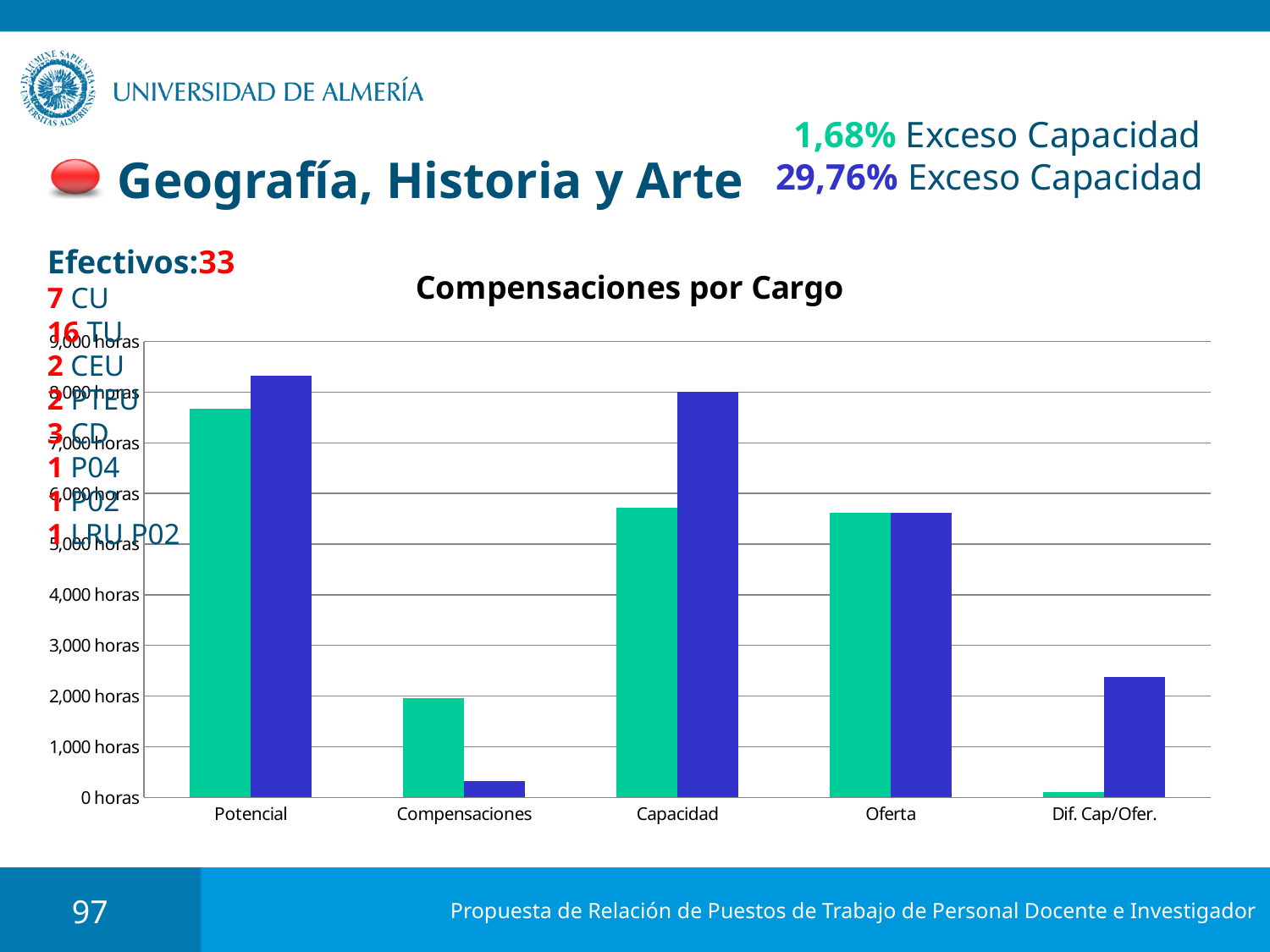
Is the green bar for Compensaciones greater or less than 3,000 horas? less Is the blue bar for Dif. Cap/Ofer. greater or less than 2,000 horas? greater Which category has the tallest green bar? Potencial Which category has the shortest blue bar? Compensaciones Which is larger, the green bar for Potencial or the green bar for Compensaciones? Potencial Is the blue bar for Capacidad greater or less than 7,000 horas? greater How many categories are shown on the x axis of the chart? 5 For Capacidad, which bar is taller, the green one or the blue one? the blue one Which category has the shortest green bar? Dif. Cap/Ofer. What kind of chart is shown on the slide? bar chart What is the title of the chart? Compensaciones por Cargo